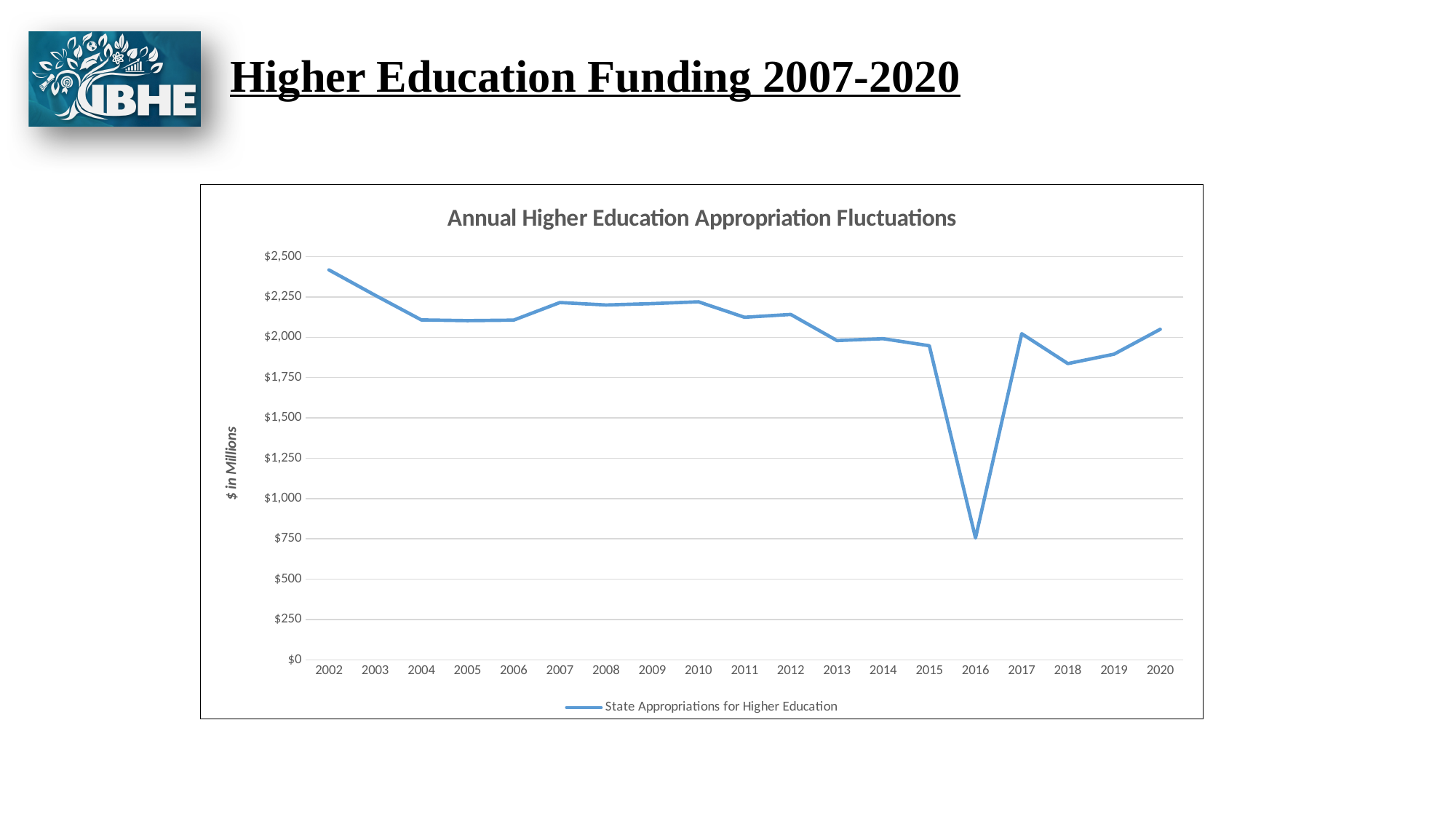
Is the value for 2011 greater or less than $2,000? greater Is the value for 2018 greater or less than $2,000? less What kind of chart is shown on the slide? line chart Which year has the lowest state appropriation for higher education? 2016 How many years are plotted along the x axis? 19 Which year has the larger value, 2016 or 2017? 2017 What is the title of the chart? Annual Higher Education Appropriation Fluctuations Is the value for 2016 greater or less than $1,000? less Which year has the highest state appropriation for higher education? 2002 How many series does the legend list? 1 Do the values rise or fall from 2018 to 2020? rise